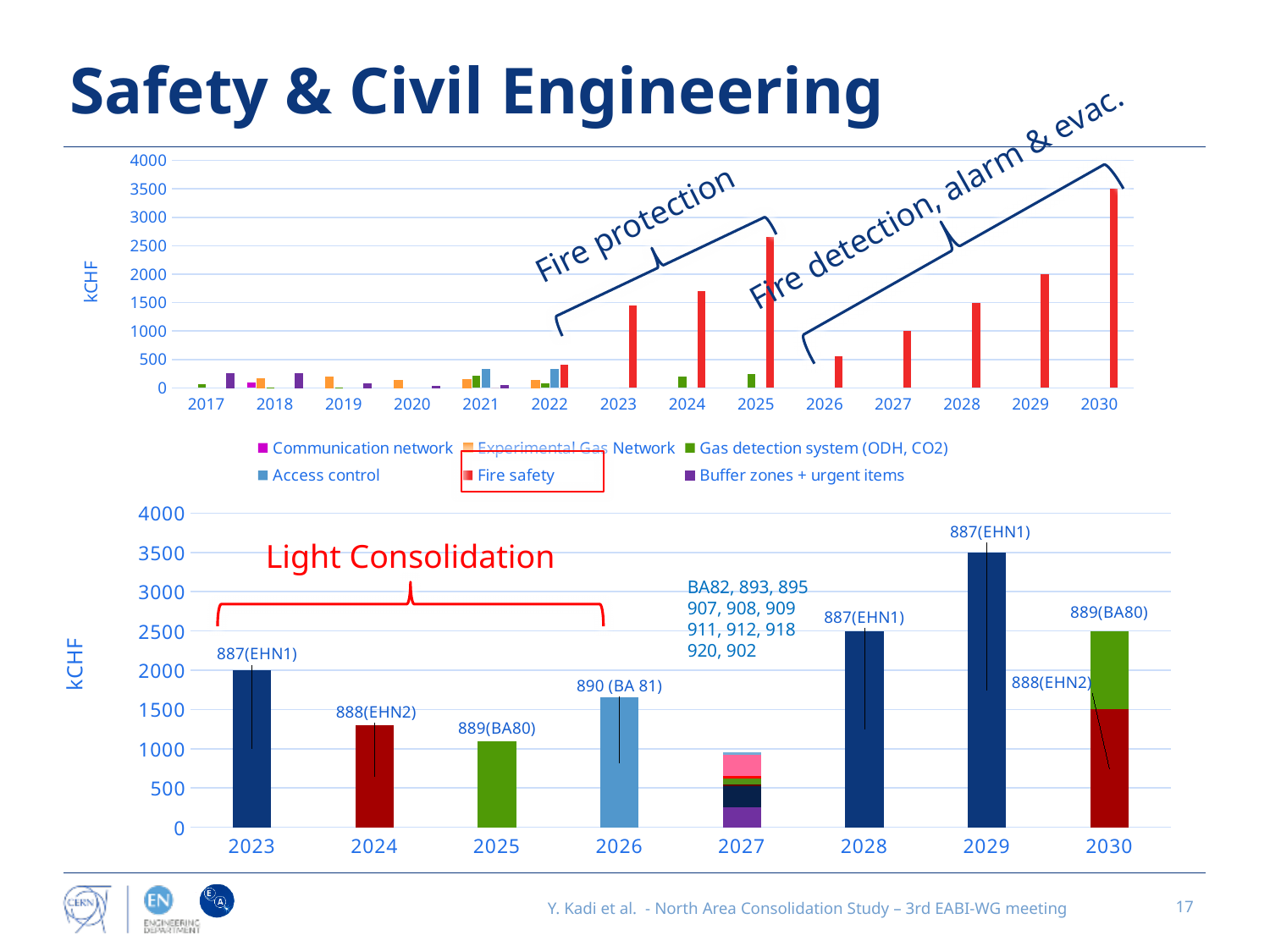
In the top chart, which year has the highest Fire safety bar? 2030 What kind of chart is the top chart on the slide? bar chart In the top chart, is the Fire safety value for 2030 greater or less than 3000? greater How many years are shown on the x axis of the top chart? 14 In the top chart, do the Fire safety bars rise or fall from 2026 to 2030? rise In the top chart, which year has the larger Fire safety bar, 2024 or 2025? 2025 How many series does the legend of the top chart list? 6 What is the y-axis label of the top chart? kCHF How many years are shown on the x axis of the bottom chart? 8 In the bottom chart, which year has the tallest bar? 2029 In the top chart, is the Fire safety value for 2026 greater or less than 1000? less In the bottom chart, which year has the larger bar, 2027 or 2028? 2028